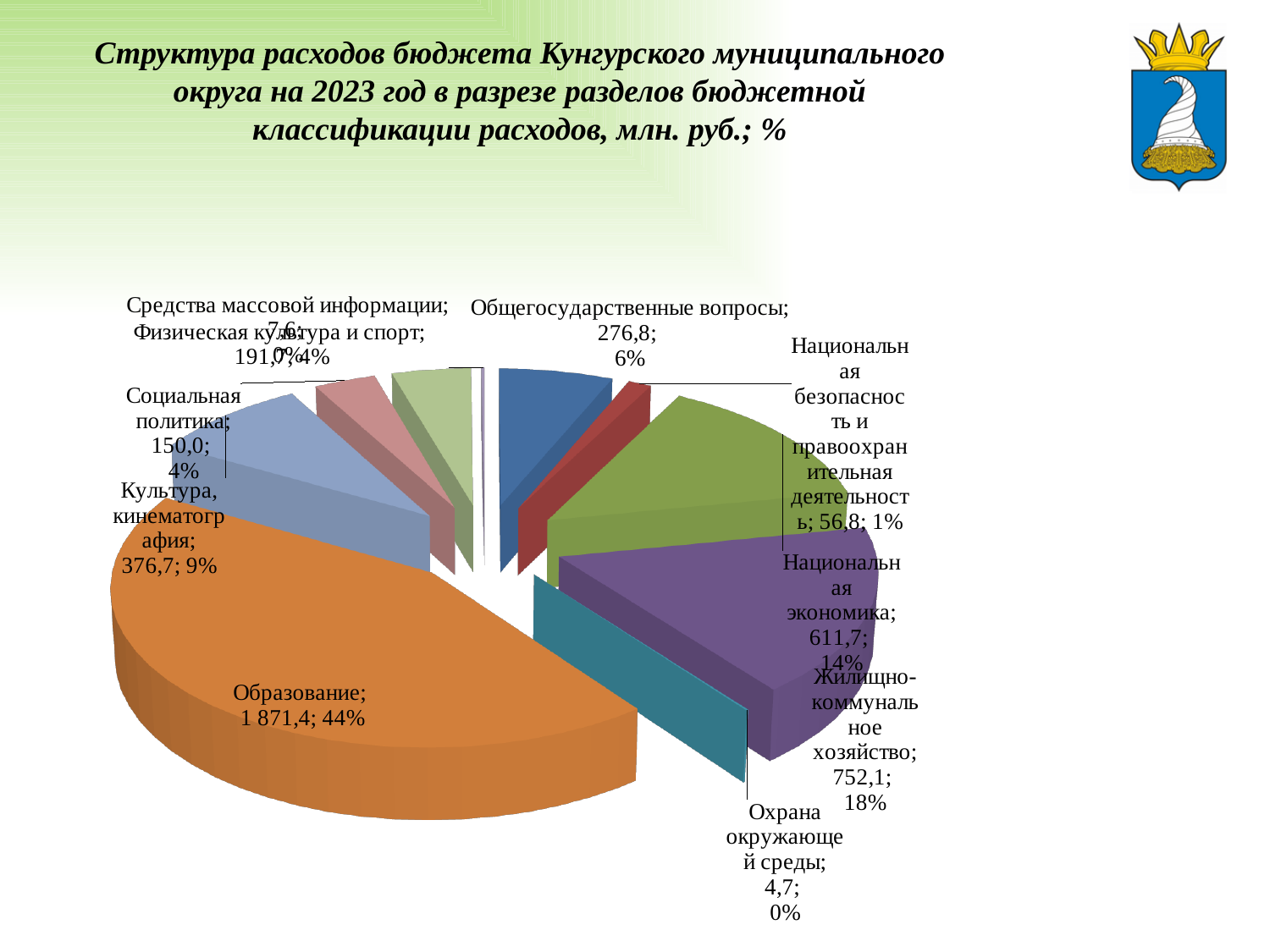
What share of the pie does Национальная экономика represent? 14% What kind of chart is shown on the slide? pie chart What is the value for Общегосударственные вопросы? 276,8 Which is larger, the value for Социальная политика or the value for Физическая культура и спорт? Физическая культура и спорт What is the value for Образование? 1 871,4 What share of the pie does Жилищно-коммунальное хозяйство represent? 18% What is the title of the chart? Структура расходов бюджета Кунгурского муниципального округа на 2023 год в разрезе разделов бюджетной классификации расходов, млн. руб.; % What is the value for Жилищно-коммунальное хозяйство? 752,1 What is the difference between the values for Жилищно-коммунальное хозяйство and Национальная экономика? 140,4 Which category has the largest slice of the pie? Образование What is the value for Национальная экономика? 611,7 What is the value for Культура, кинематография? 376,7